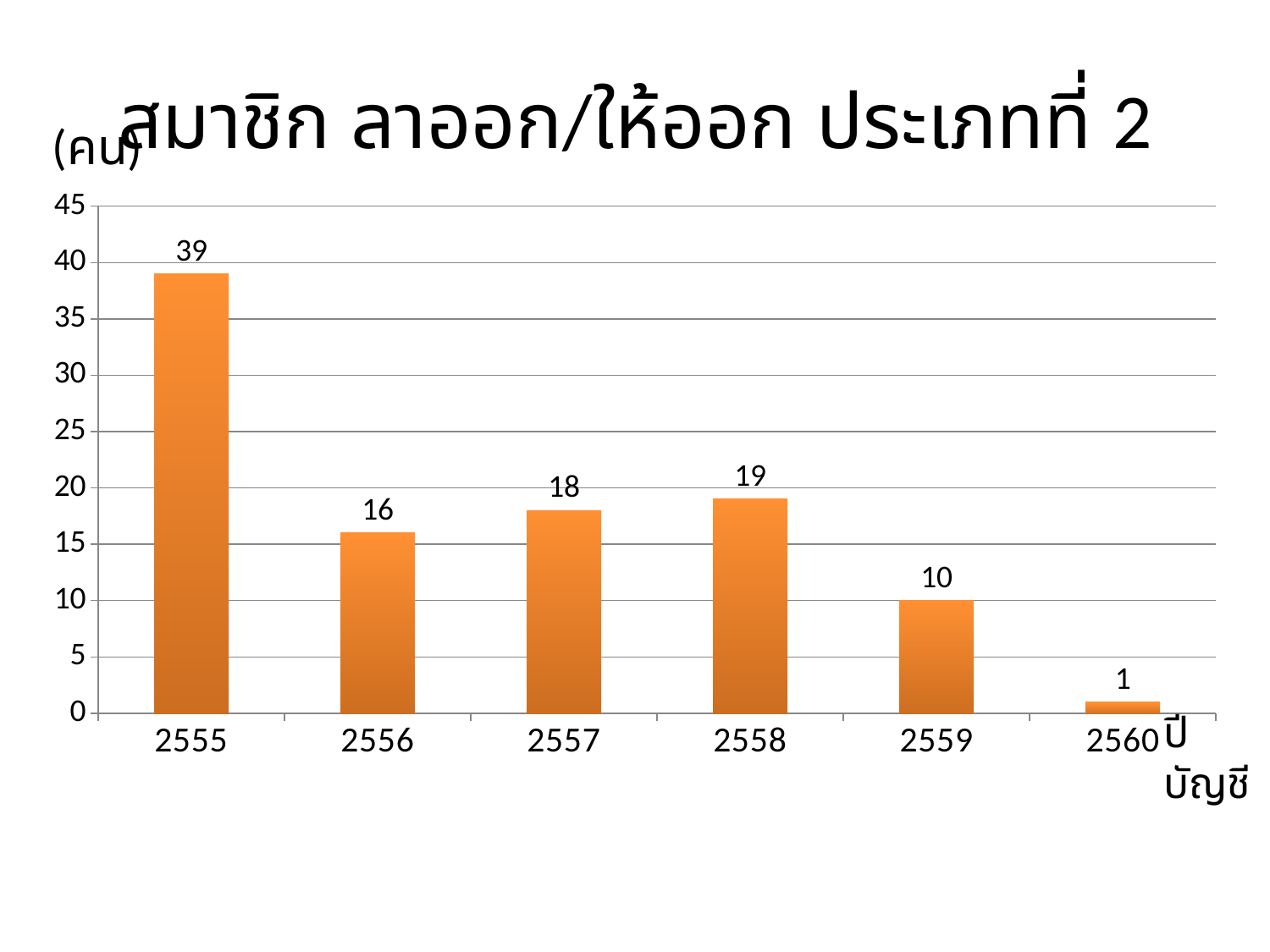
Is the value for 2555 greater or less than 35? greater Which is larger, the value for 2557 or the value for 2559? 2557 How many years are shown on the x axis? 6 What is the value for 2555? 39 Which year has the highest value? 2555 What is the difference between the values for 2555 and 2556? 23 What is the value for 2560? 1 What is the title of the chart? สมาชิก ลาออก/ให้ออก ประเภทที่ 2 Which year has the lowest value? 2560 What is the difference between the values for 2559 and 2560? 9 What is the value for 2558? 19 What kind of chart is this? bar chart